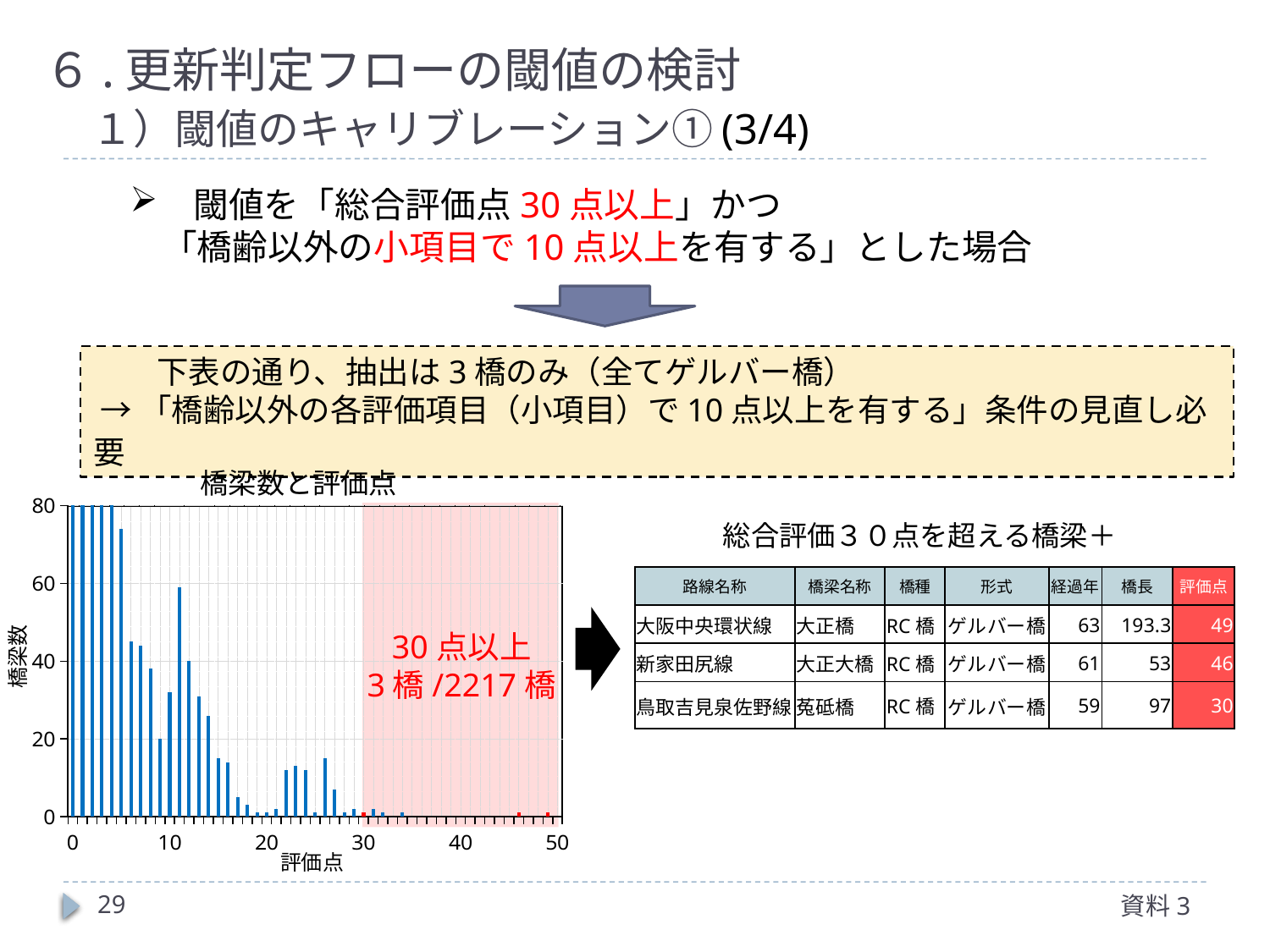
What kind of chart is the "橋梁数と評価点" chart? bar chart In the "橋梁数と評価点" chart, is the value for 評価点 12 greater or less than 20? greater In the "橋梁数と評価点" chart, is the value for 評価点 26 greater or less than 20? less In the "橋梁数と評価点" chart, is the value for 評価点 17 greater or less than 20? less In the "橋梁数と評価点" chart, do the bar values generally rise or fall as 評価点 increases from 0 to 50? fall What label is shown on the x axis of the "橋梁数と評価点" chart? 評価点 In the "橋梁数と評価点" chart, which has the larger value, 評価点 11 or 評価点 9? 評価点 11 What is the title of the chart on the left of the slide? 橋梁数と評価点 In the "橋梁数と評価点" chart, which has the larger value, 評価点 5 or 評価点 15? 評価点 5